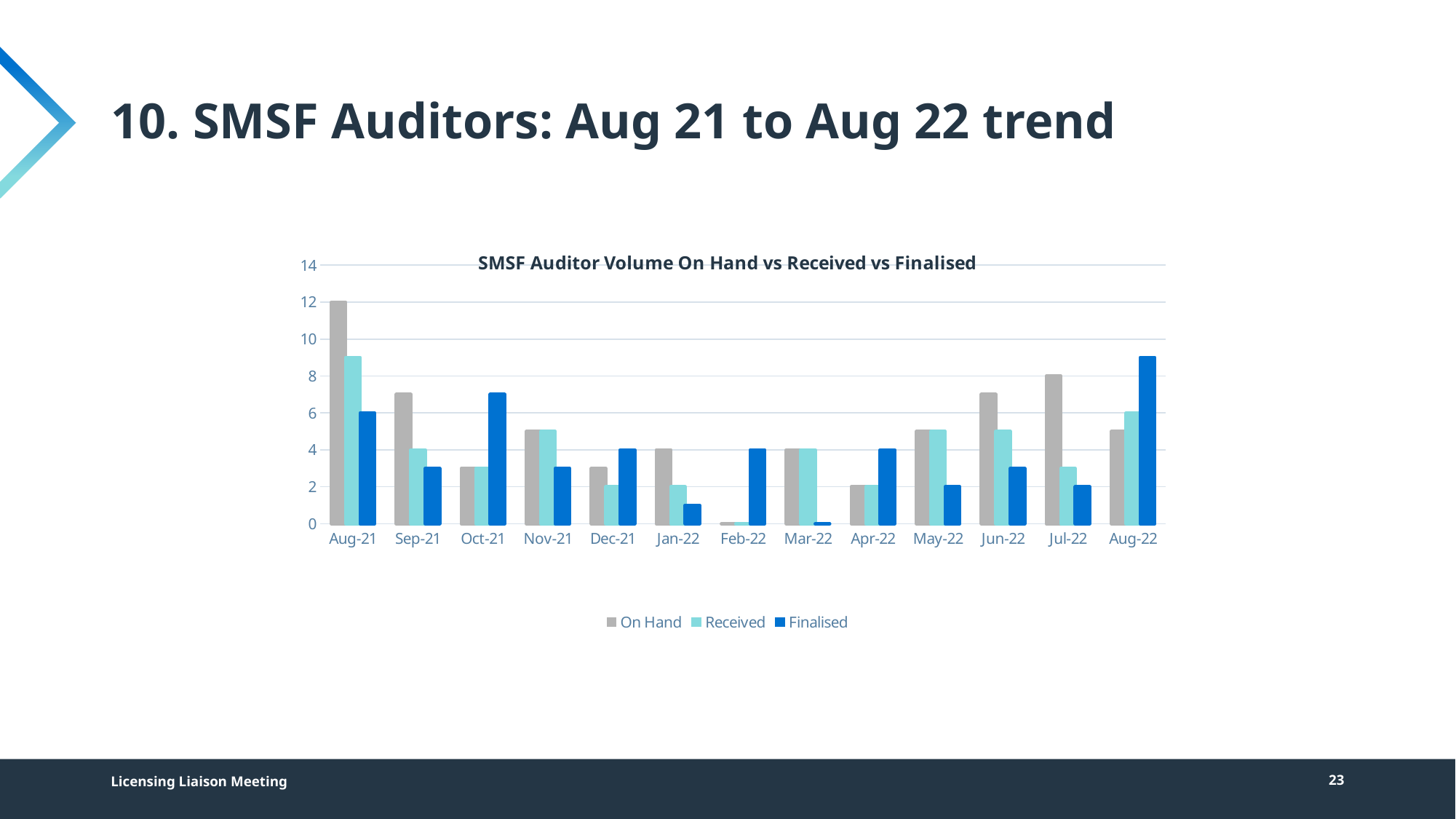
In which month is the Finalised value highest? Aug-22 In Oct-21, which is larger: On Hand or Finalised? Finalised How many series does the legend list? 3 In which month is the On Hand value lowest? Feb-22 In which month is the On Hand value highest? Aug-21 What type of chart is shown on the slide? Bar chart Is the Finalised value for Aug-22 greater or less than 8? greater What is the Received value for Aug-22? 6 What is the On Hand value for Jul-22? 8 How many months are shown on the x axis? 13 What is the On Hand value for Aug-21? 12 What is the difference between the On Hand and Finalised values for Aug-21? 6